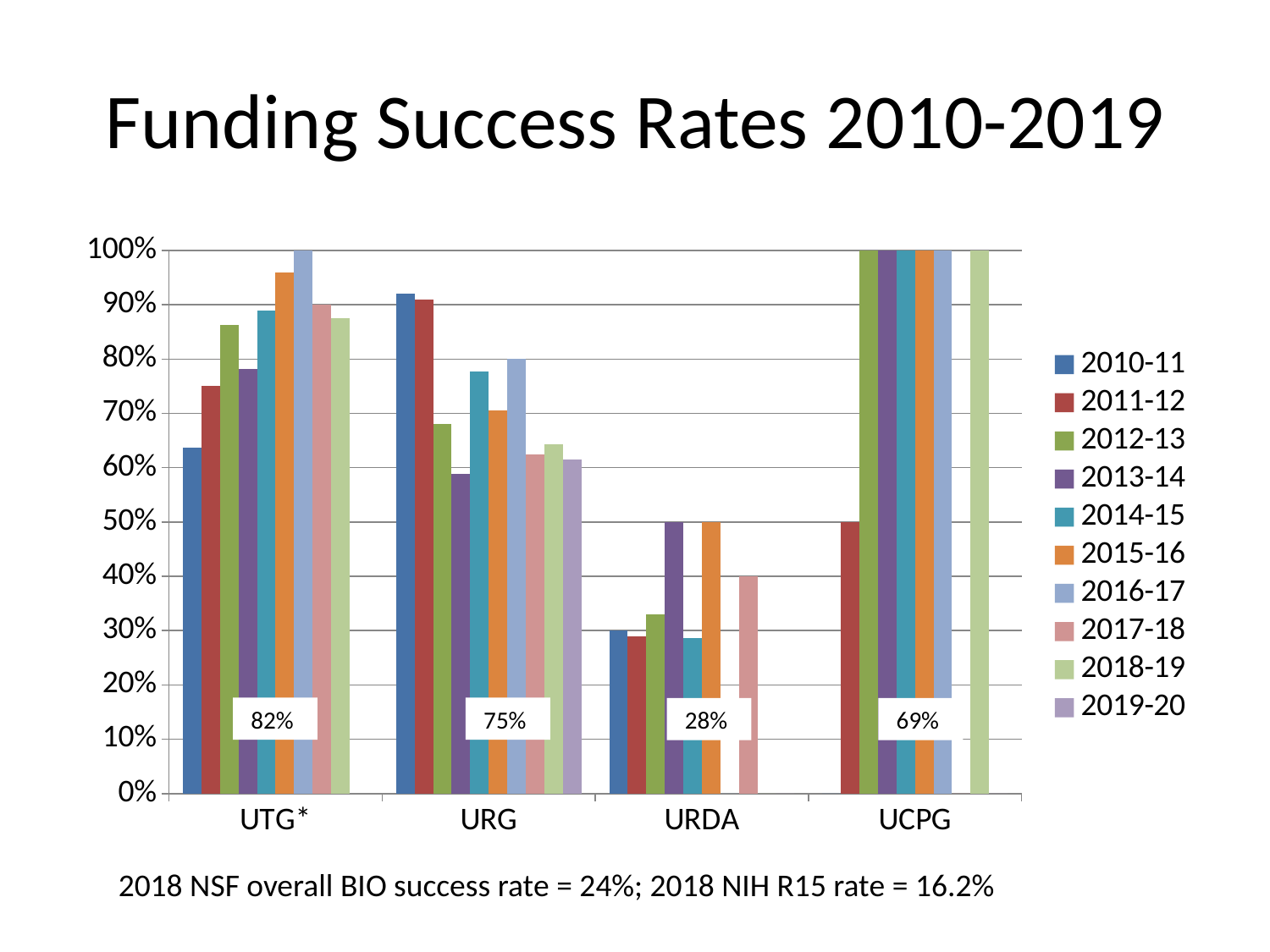
Which series has the highest value in the UTG* category? 2016-17 What kind of chart is shown on the slide? bar chart How many series does the legend list? 10 How many categories are shown on the x axis? 4 Is the value for 2010-11 in the UTG* category greater or less than 60%? greater In the URDA category, what is the difference between the 2013-14 value and the 2017-18 value? 10% What is the value for 2017-18 in the URDA category? 40% What is the value for 2016-17 in the UTG* category? 100% Is the value for 2010-11 in the URG category greater or less than 90%? greater What is the value for 2011-12 in the UCPG category? 50% In the UTG* category, which is larger: the value for 2015-16 or the value for 2011-12? 2015-16 What percentage is printed in the label box over the URDA bars? 28%